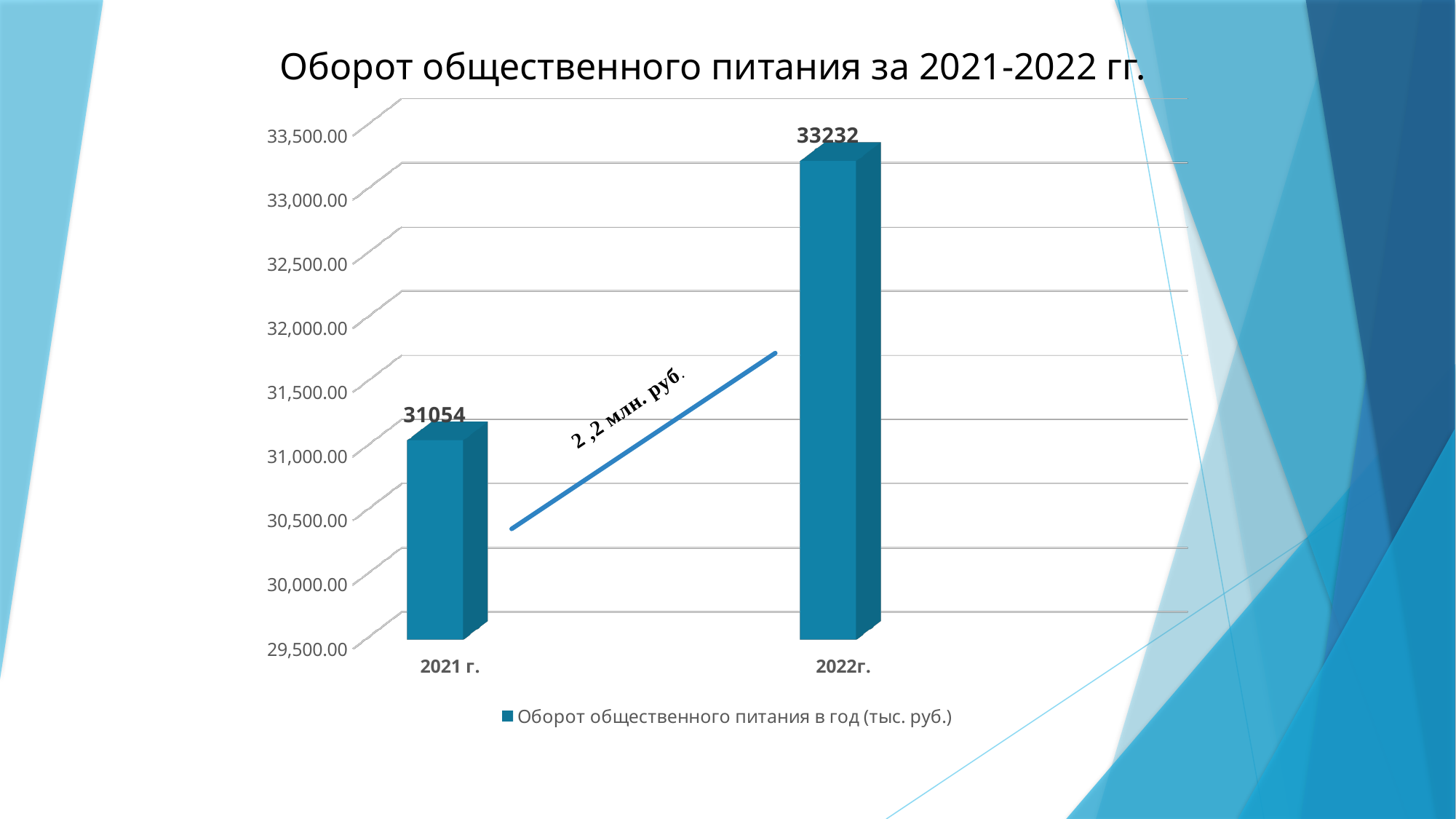
Is the value for 2021 г. greater or less than 31,500.00? less Which year has the lowest value? 2021 г. How many series does the legend list? 1 What kind of chart is shown? bar chart Which is larger, the value for 2021 г. or the value for 2022г.? 2022г. Is the value for 2022г. greater or less than 33,000.00? greater What is the value for 2021 г.? 31054 What is the value for 2022г.? 33232 How many categories are shown on the x axis? 2 What is the difference between the values for 2022г. and 2021 г.? 2178 Which year has the highest value? 2022г. Do the values rise or fall from 2021 г. to 2022г.? rise